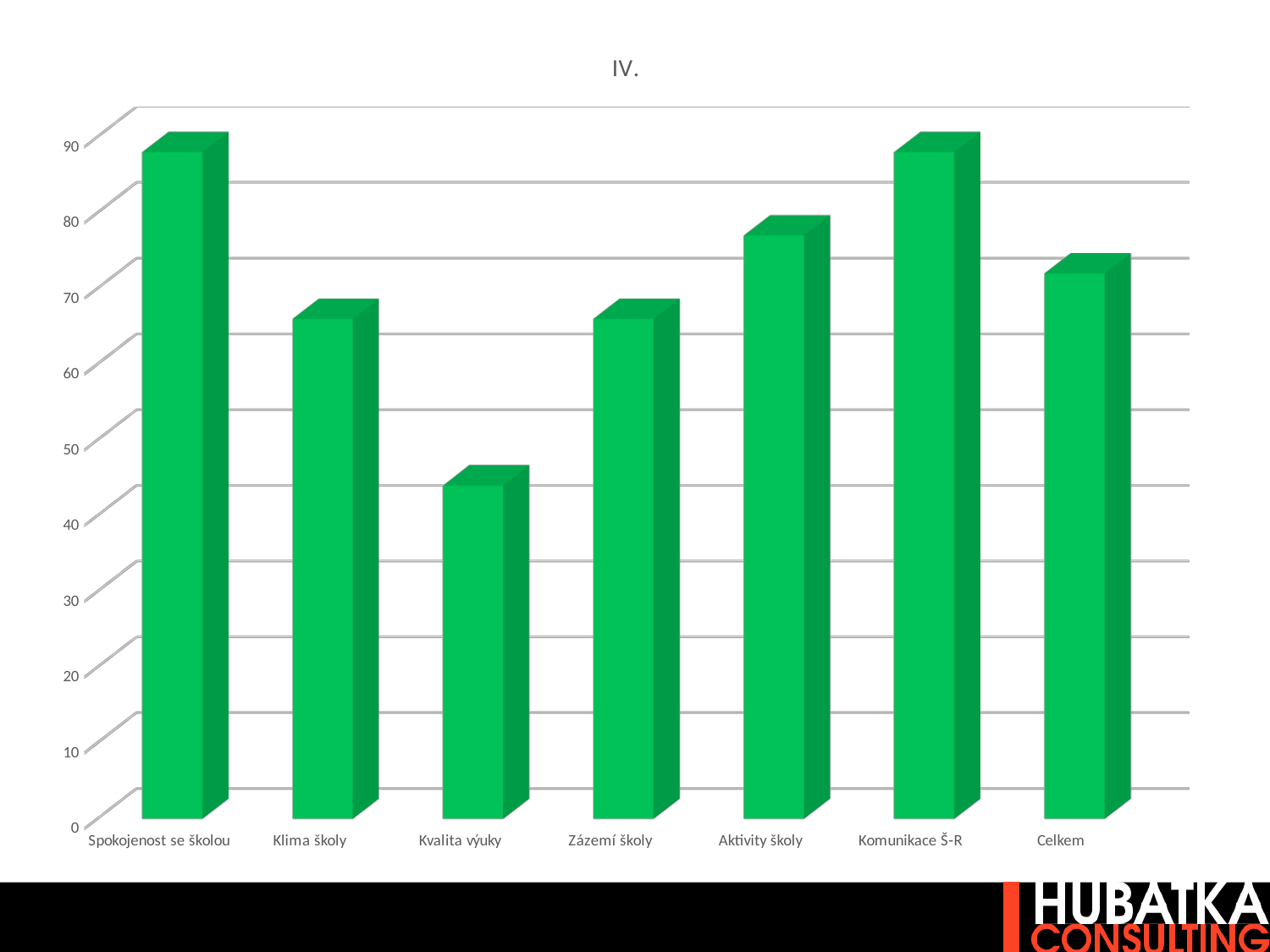
What kind of chart is shown on the slide? bar chart How many categories are shown on the x axis of the chart? 7 Is the value for Kvalita výuky greater or less than 50? less Which is larger, the value for Celkem or the value for Kvalita výuky? Celkem Which category has the lowest value in the chart? Kvalita výuky Is the value for Klima školy greater or less than 60? greater What is the title of the chart? IV. Is the value for Aktivity školy greater or less than 70? greater Which is larger, the value for Aktivity školy or the value for Klima školy? Aktivity školy What colour are the bars in the chart? green